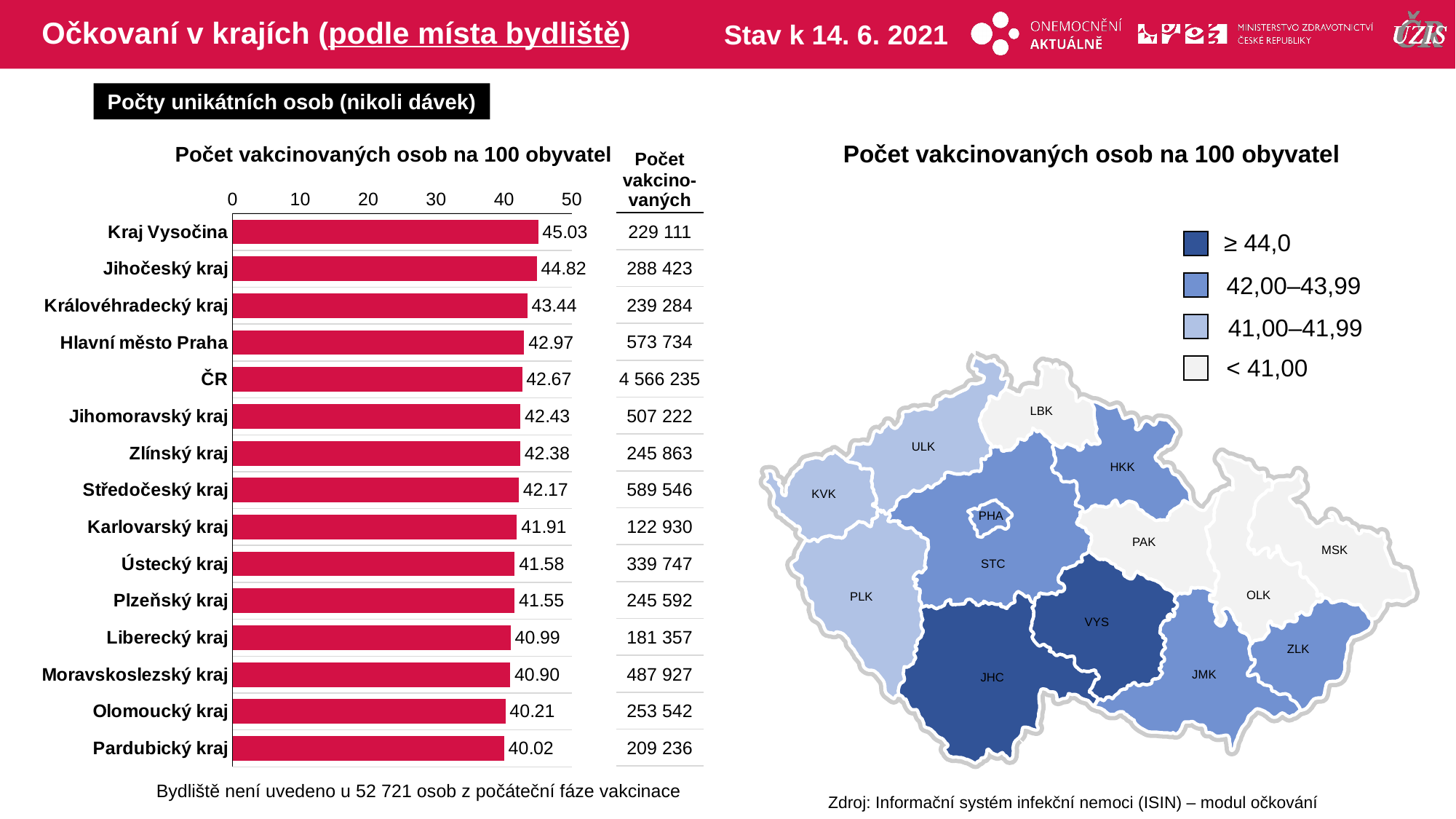
What is the title of the bar chart on the left? Počet vakcinovaných osob na 100 obyvatel What type of chart is shown on the left of the slide? bar chart In the bar chart on the left, what is the value for Hlavní město Praha? 42.97 In the bar chart on the left, is the value for Liberecký kraj greater or less than 40? greater In the bar chart on the left, which category has the lowest value? Pardubický kraj In the bar chart on the left, which category has the highest value? Kraj Vysočina How many categories (bars) does the bar chart on the left show? 15 In the bar chart on the left, what is the difference between the values for Jihočeský kraj and Královéhradecký kraj? 1.38 In the bar chart on the left, what is the value for ČR? 42.67 In the bar chart on the left, what is the value for Kraj Vysočina? 45.03 In the bar chart on the left, what is the difference between the values for Kraj Vysočina and Pardubický kraj? 5.01 In the bar chart on the left, which has a larger value, Zlínský kraj or Olomoucký kraj? Zlínský kraj